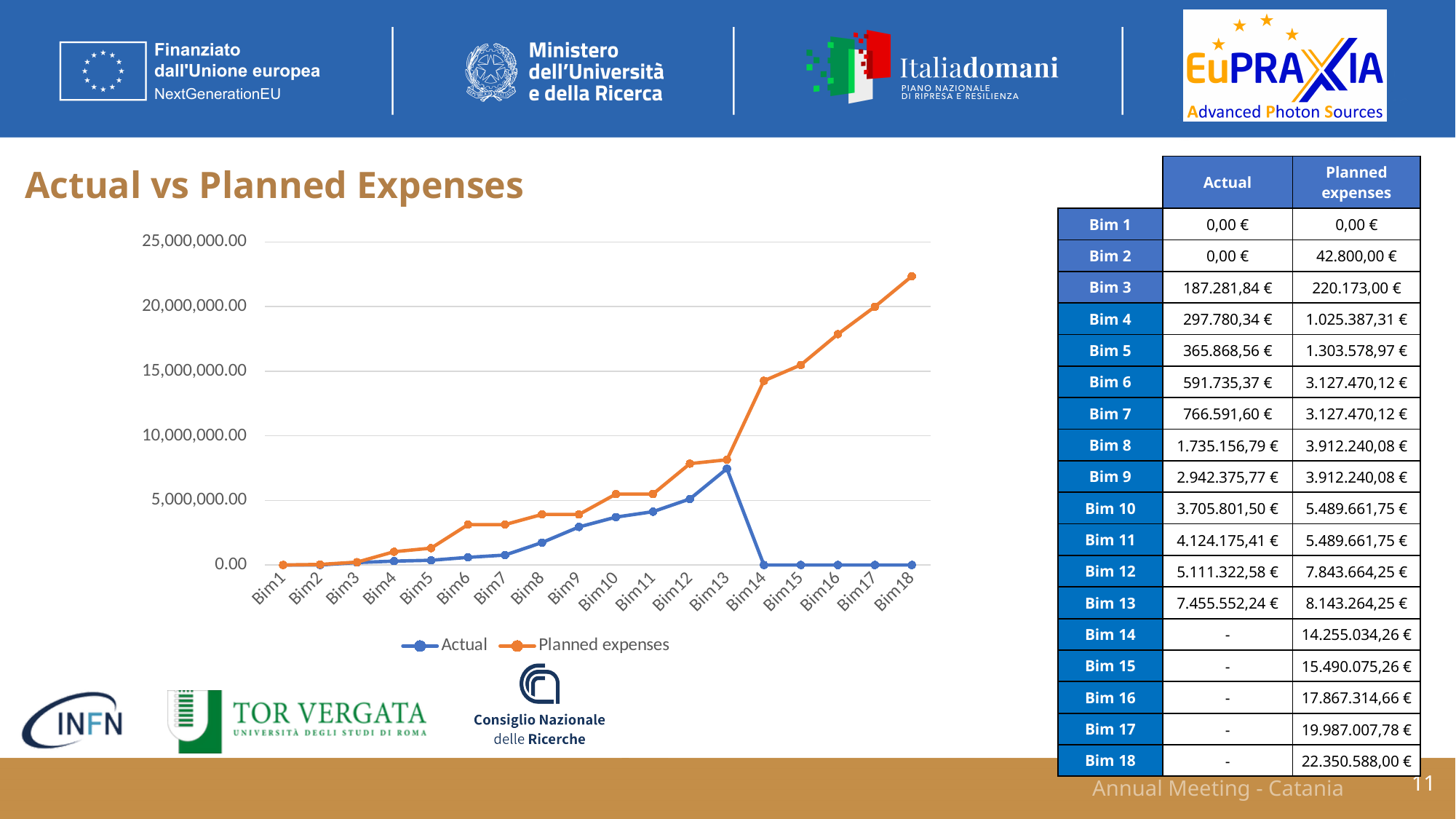
At Bim 10, which is larger, Actual or Planned expenses? Planned expenses What is the Actual value at Bim 13? 7.455.552,24 € At which Bim are Planned expenses highest? Bim 18 Do the Planned expenses values rise or fall from Bim1 to Bim18? rise What is the value of Planned expenses at Bim 18? 22.350.588,00 € What is the difference between Planned expenses and Actual at Bim 13? 687.712,01 € What is the Actual value at Bim 2? 0,00 € Is the Actual value at Bim 12 greater or less than 10,000,000.00? less How many series does the chart legend list? 2 What kind of chart is shown on the slide? line chart Is the Planned expenses value at Bim 14 greater or less than 10,000,000.00? greater How many Bim categories are plotted along the x axis? 18